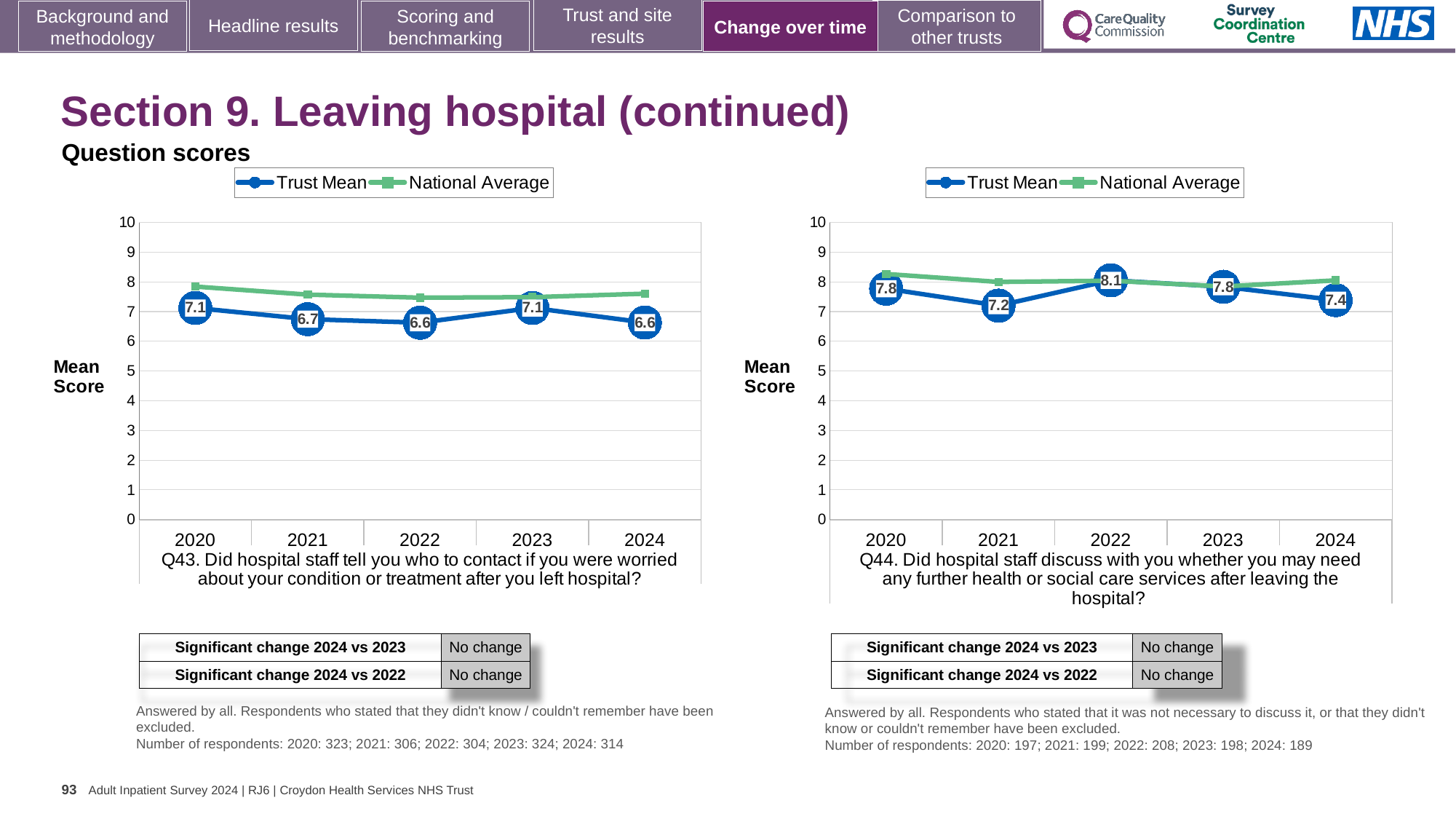
What kind of chart is the Q43 chart (left)? Line chart In the Q43 chart (left), what is the difference between the Trust Mean scores for 2020 and 2022? 0.5 In the Q44 chart (right), does the Trust Mean rise or fall from 2022 to 2024? Fall In the Q44 chart (right), which is larger, the Trust Mean for 2021 or the Trust Mean for 2023? 2023 In the Q44 chart (right), what is the Trust Mean score for 2022? 8.1 In the Q44 chart (right), what is the Trust Mean score for 2024? 7.4 In the Q43 chart (left), is the National Average for 2020 greater or less than 7? greater How many years are plotted on the x axis of the Q43 chart (left)? 5 In the Q44 chart (right), which year has the lowest Trust Mean score? 2021 In the Q43 chart (left), what is the Trust Mean score for 2021? 6.7 In the Q44 chart (right), which year has the highest Trust Mean score? 2022 How many series does the legend of the Q44 chart (right) list? 2